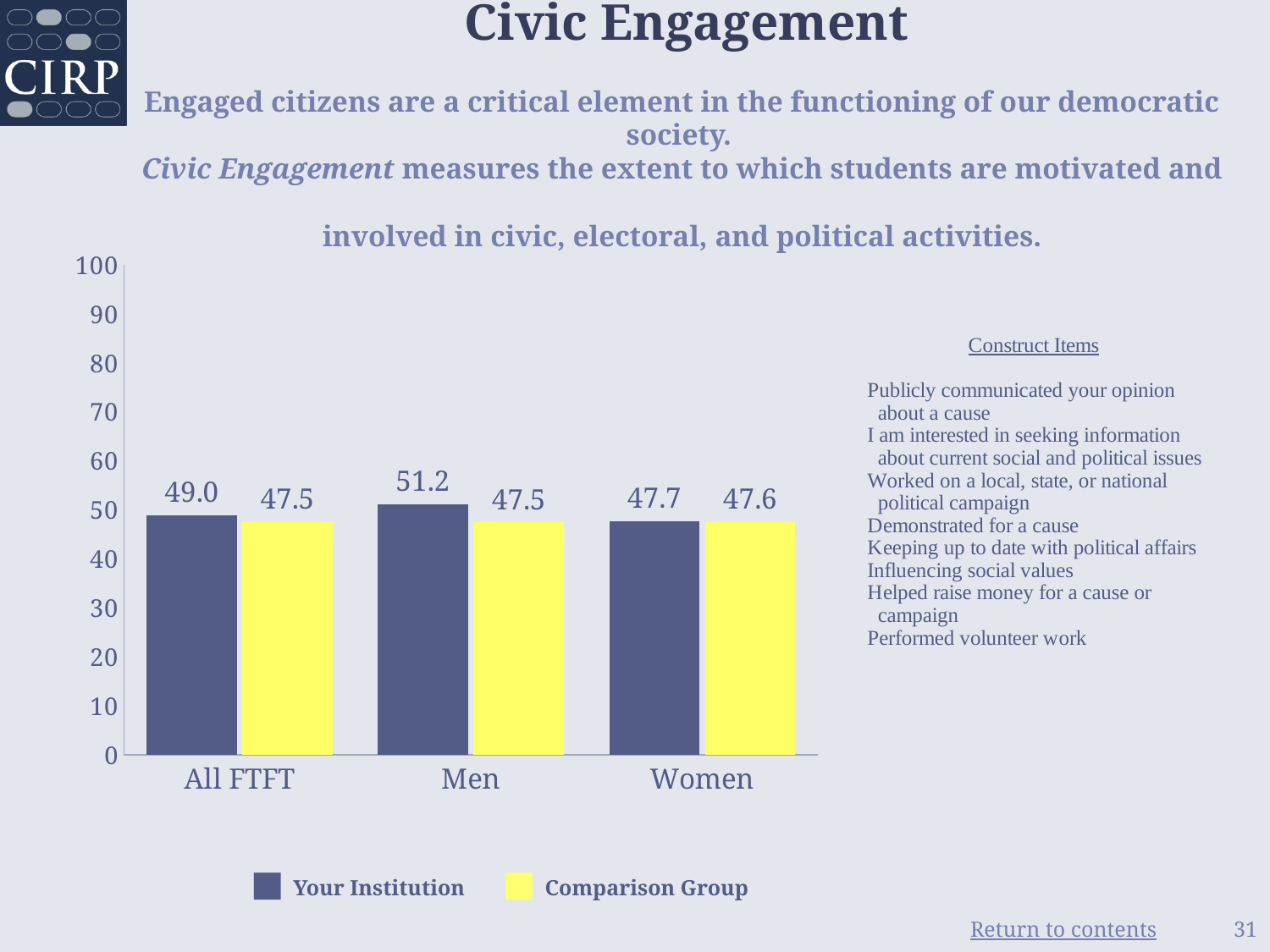
For All FTFT, which is larger: Your Institution or Comparison Group? Your Institution What is the Your Institution value for All FTFT? 49.0 Which category has the highest Your Institution value? Men What is the Comparison Group value for Women? 47.6 How many categories are shown on the x axis? 3 What is the Your Institution value for Men? 51.2 Is the Your Institution value for Men greater or less than 50? greater What is the difference between the Your Institution and Comparison Group values for Men? 3.7 How many series does the legend list? 2 What kind of chart is shown on the slide? bar chart What is the difference between the Your Institution and Comparison Group values for All FTFT? 1.5 Which category has the lowest Your Institution value? Women